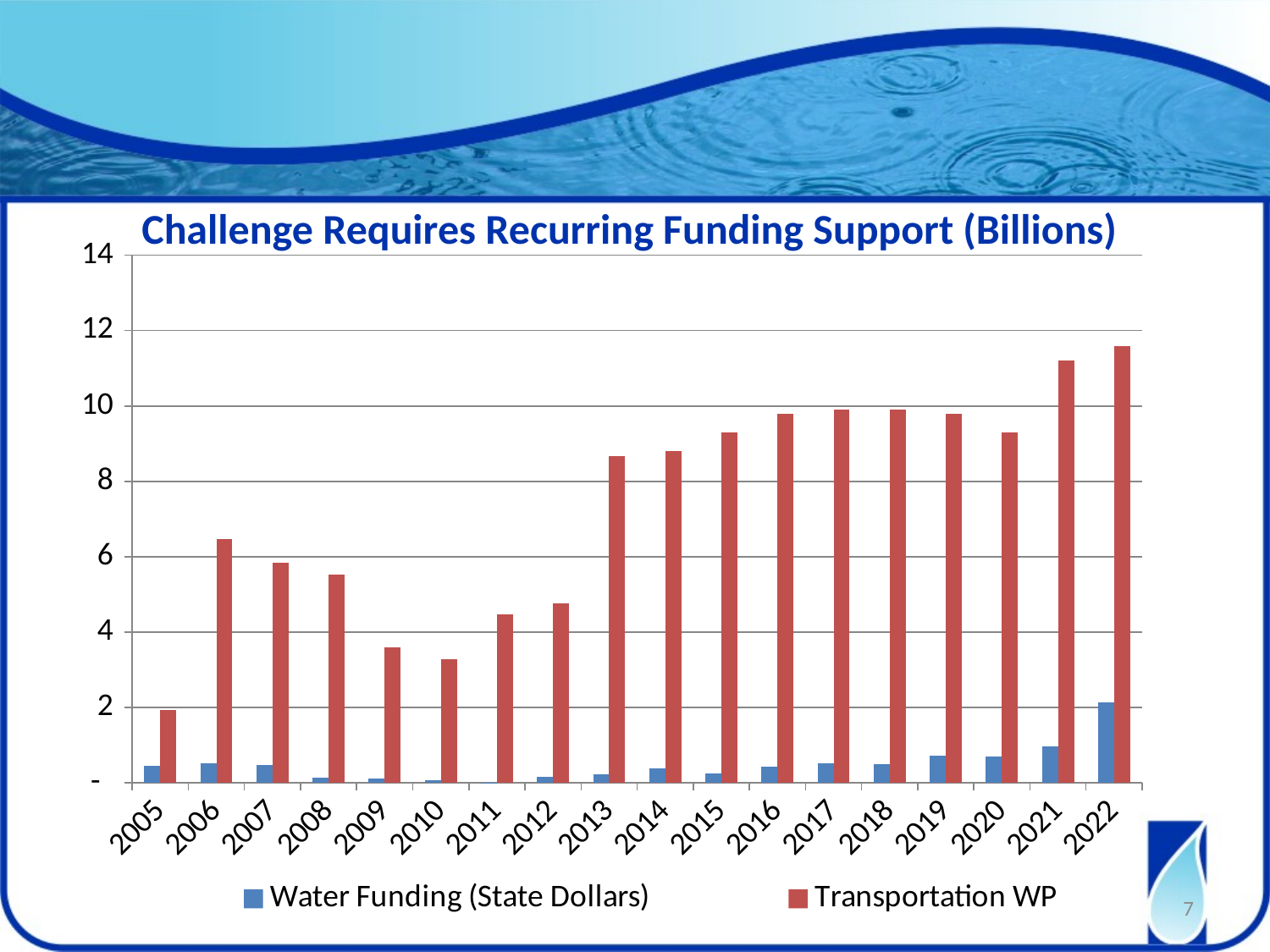
What is the title of the chart? Challenge Requires Recurring Funding Support (Billions) Which year has the highest Water Funding (State Dollars) value? 2022 Is the Transportation WP value for 2021 greater or less than 10? greater Which series is shown in red? Transportation WP Which year has the lowest Transportation WP value? 2005 Is the Transportation WP value for 2009 greater or less than 4? less Do the Transportation WP values rise or fall from 2010 to 2017? rise How many years are shown on the x axis? 18 Which is larger, the Transportation WP value for 2012 or for 2013? 2013 How many series does the legend list? 2 Is the Transportation WP value for 2006 greater or less than 6? greater What kind of chart is shown on the slide? Bar chart